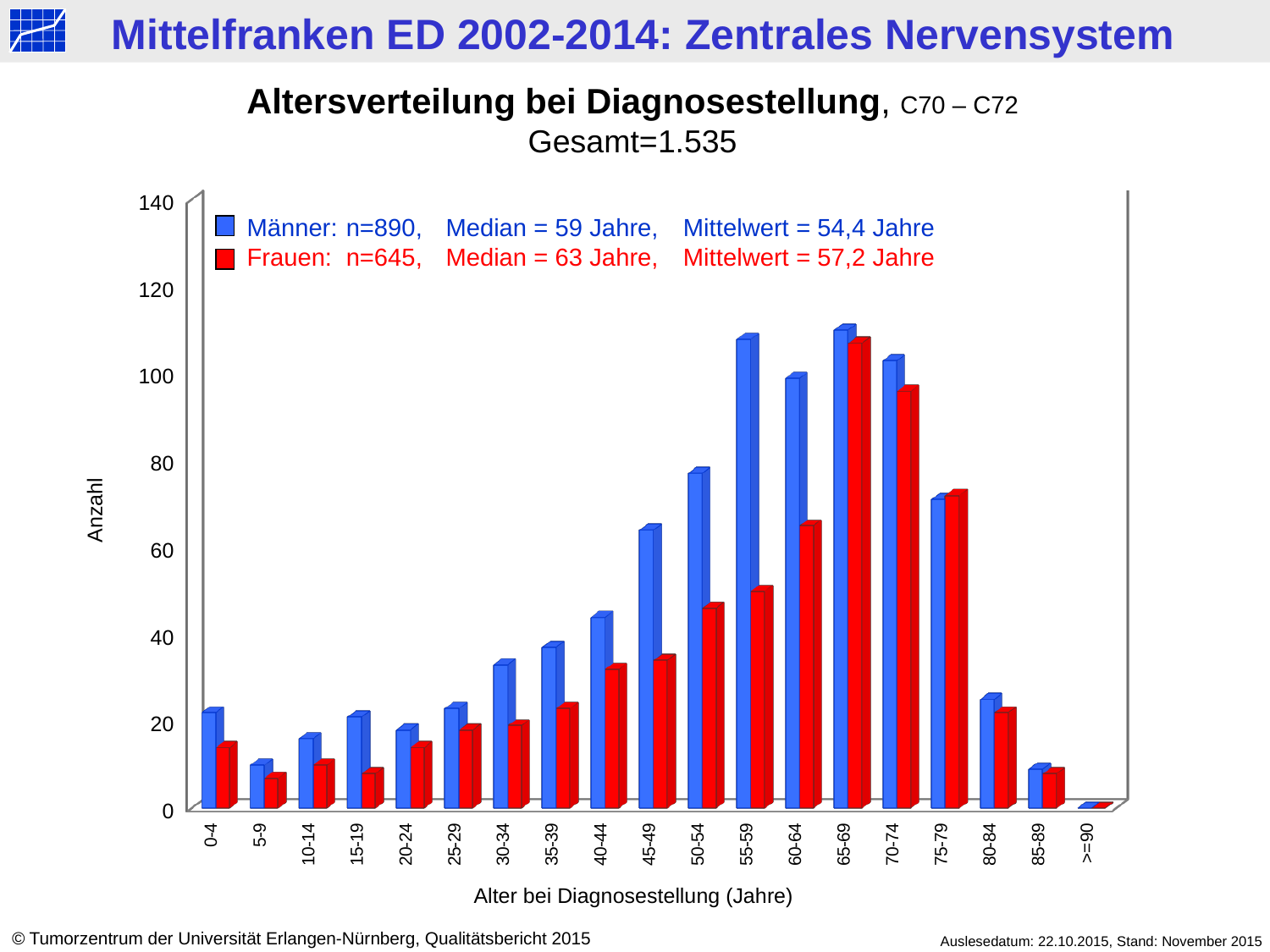
Which age group has the highest value for Frauen? 65-69 How many age categories are shown on the x axis? 19 Is the value for Frauen in the 55-59 age group greater or less than 60? less Which is larger in the 60-64 age group, the value for Männer or for Frauen? Männer According to the legend, what is the median age for Frauen? 63 Jahre Is the value for Männer in the 55-59 age group greater or less than 100? greater How many series does the legend list? 2 Is the value for Frauen in the 0-4 age group greater or less than 20? less Which age group has the lowest value for Männer? >=90 What kind of chart is shown on the slide? bar chart Which is larger in the 45-49 age group, the value for Männer or for Frauen? Männer